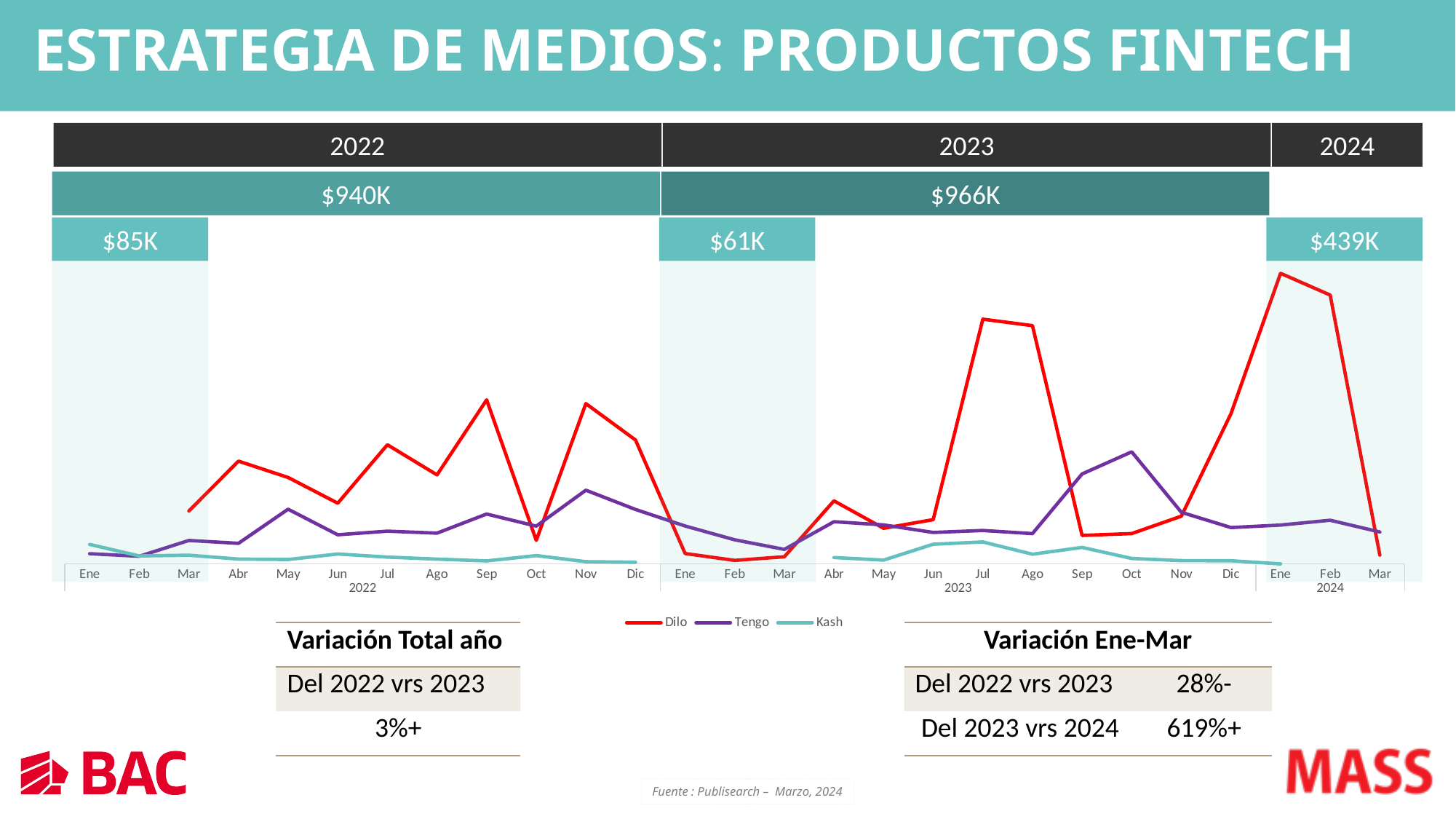
In which month does the Dilo series reach its highest value? Ene 2024 How many months are plotted along the x axis of the chart? 27 Which series are listed in the chart legend? Dilo, Tengo, Kash In Sep 2022, which is higher, Dilo or Tengo? Dilo Which series stays lowest across the chart? Kash Does the Dilo series rise or fall from Ene 2024 to Mar 2024? Fall In Oct 2023, which is higher, Dilo or Tengo? Tengo Does the Dilo series rise or fall from Mar 2023 to Jul 2023? Rise Which series is drawn with the red line? Dilo How many series does the chart legend list? 3 What kind of chart is shown on the slide? Line chart Which series reaches the highest point on the chart? Dilo